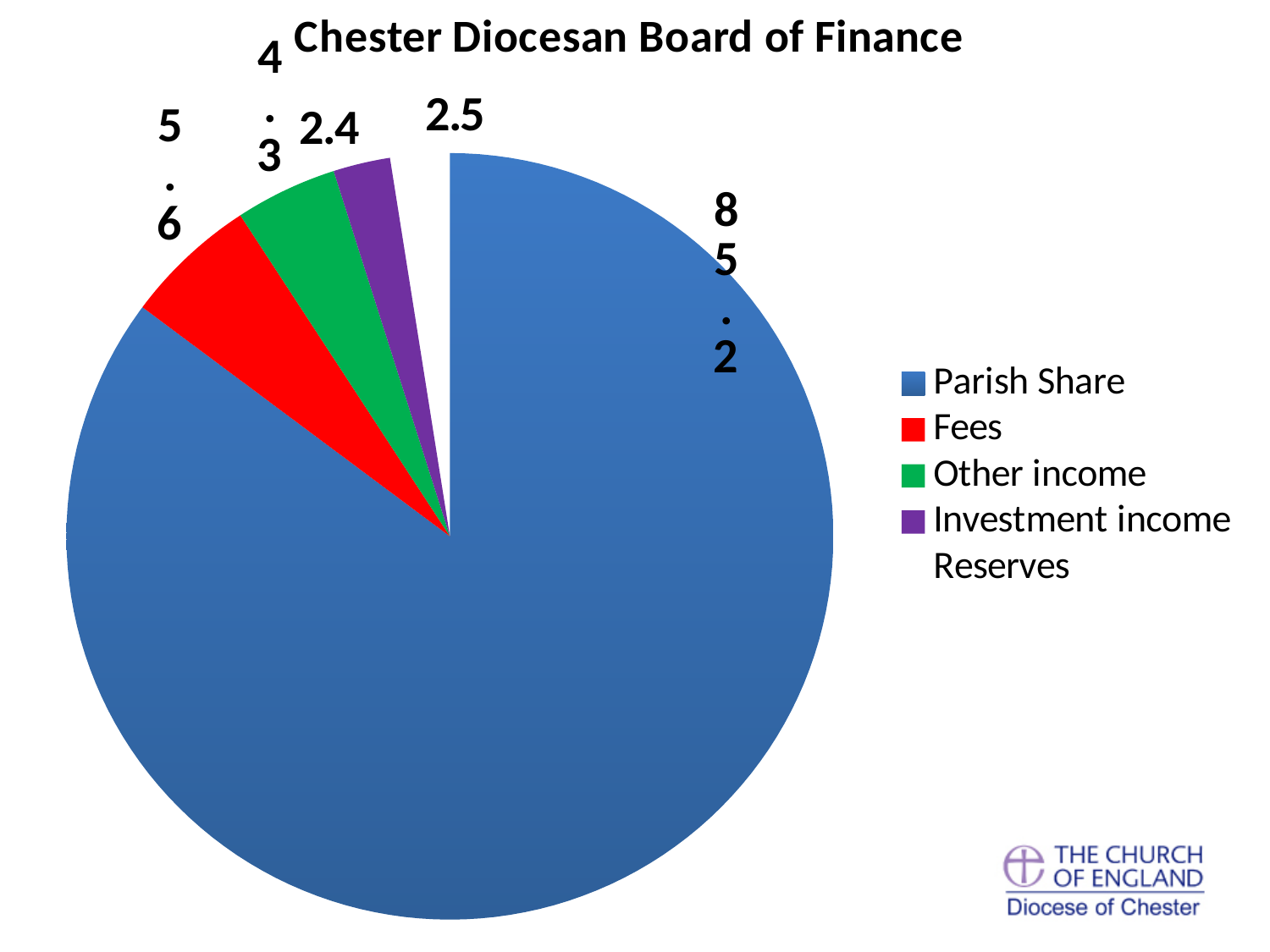
Which category has the smallest value in the pie chart? Investment income What is the value shown for Fees? 5.6 What is the value shown for Parish Share? 85.2 What is the value shown for Reserves? 2.5 What is the value shown for Investment income? 2.4 What kind of chart is shown on the slide? Pie chart What is the difference between the values for Fees and Other income? 1.3 What is the value shown for Other income? 4.3 How many categories does the pie chart show? 5 What is the title of the chart? Chester Diocesan Board of Finance Which category has the largest slice of the pie? Parish Share Which is larger, the value for Fees or the value for Other income? Fees